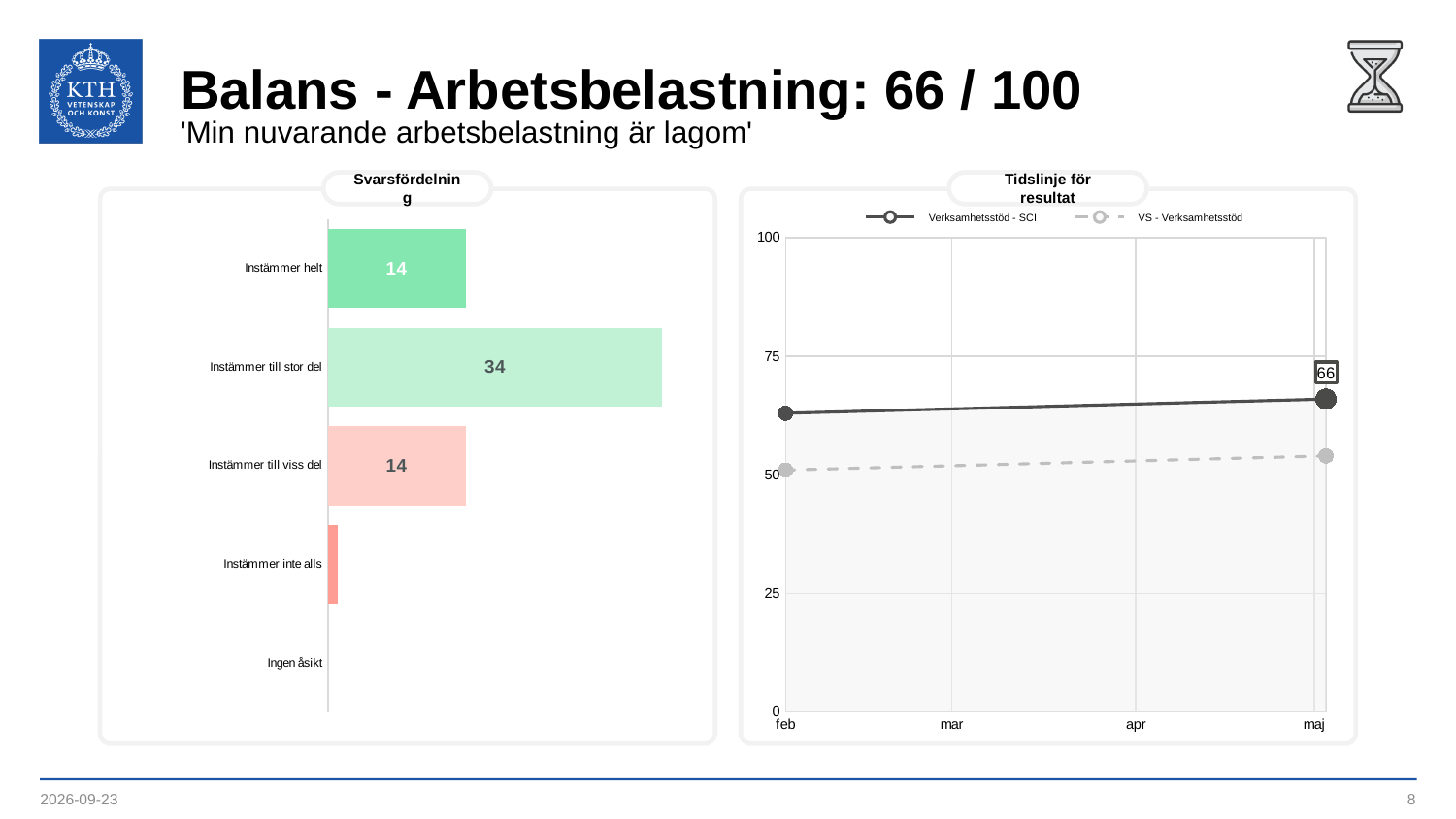
What kind of chart is the 'Svarsfördelning' chart? bar chart In the 'Svarsfördelning' chart, which category has the highest value? Instämmer till stor del In the 'Svarsfördelning' chart, what is the difference between 'Instämmer till stor del' and 'Instämmer till viss del'? 20 In the 'Tidslinje för resultat' chart, is the value for 'VS - Verksamhetsstöd' in feb greater or less than 75? less In the 'Tidslinje för resultat' chart, does the 'Verksamhetsstöd - SCI' line rise or fall from feb to maj? rise What kind of chart is the 'Tidslinje för resultat' chart? line chart In the 'Tidslinje för resultat' chart, which series is higher in maj, 'Verksamhetsstöd - SCI' or 'VS - Verksamhetsstöd'? Verksamhetsstöd - SCI In the 'Tidslinje för resultat' chart, what is the value for 'Verksamhetsstöd - SCI' in maj? 66 In the 'Tidslinje för resultat' chart, how many series does the legend list? 2 In the 'Svarsfördelning' chart, how many categories are shown on the axis? 5 In the 'Svarsfördelning' chart, what is the value for 'Instämmer helt'? 14 In the 'Svarsfördelning' chart, what is the value for 'Instämmer till stor del'? 34